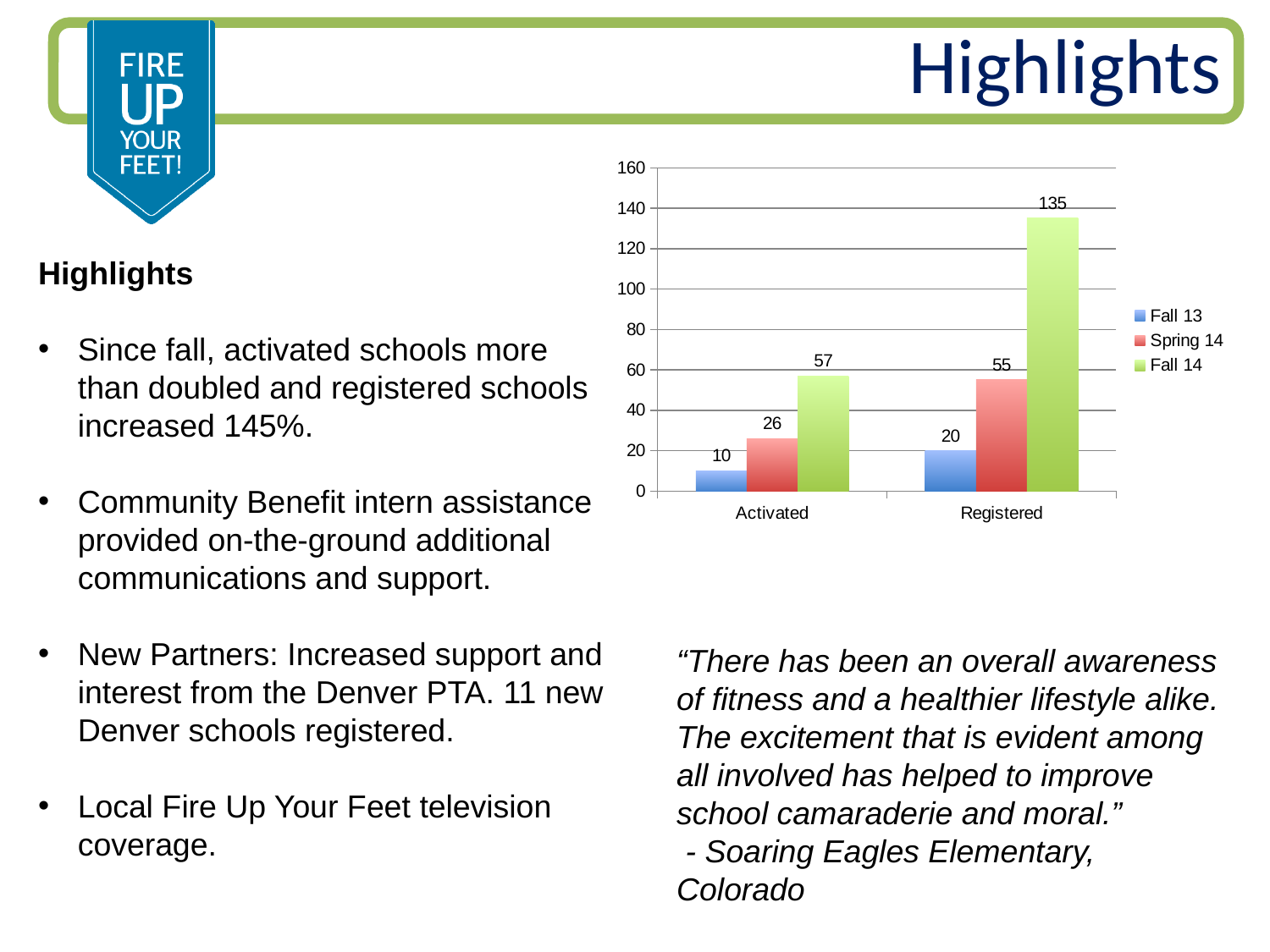
What is the Fall 13 value for Activated? 10 What kind of chart is shown on the slide? Bar chart How many categories are shown on the x axis? 2 Which series has the lowest value for Activated? Fall 13 Which series has the highest value for Registered? Fall 14 Which is larger, the Fall 14 value for Activated or the Spring 14 value for Registered? Fall 14 value for Activated Is the Fall 14 value for Registered greater or less than 120? greater What is the Spring 14 value for Registered? 55 What is the Fall 14 value for Registered? 135 What is the difference between the Fall 14 and Fall 13 values for Registered? 115 What is the Spring 14 value for Activated? 26 How many series does the legend list? 3